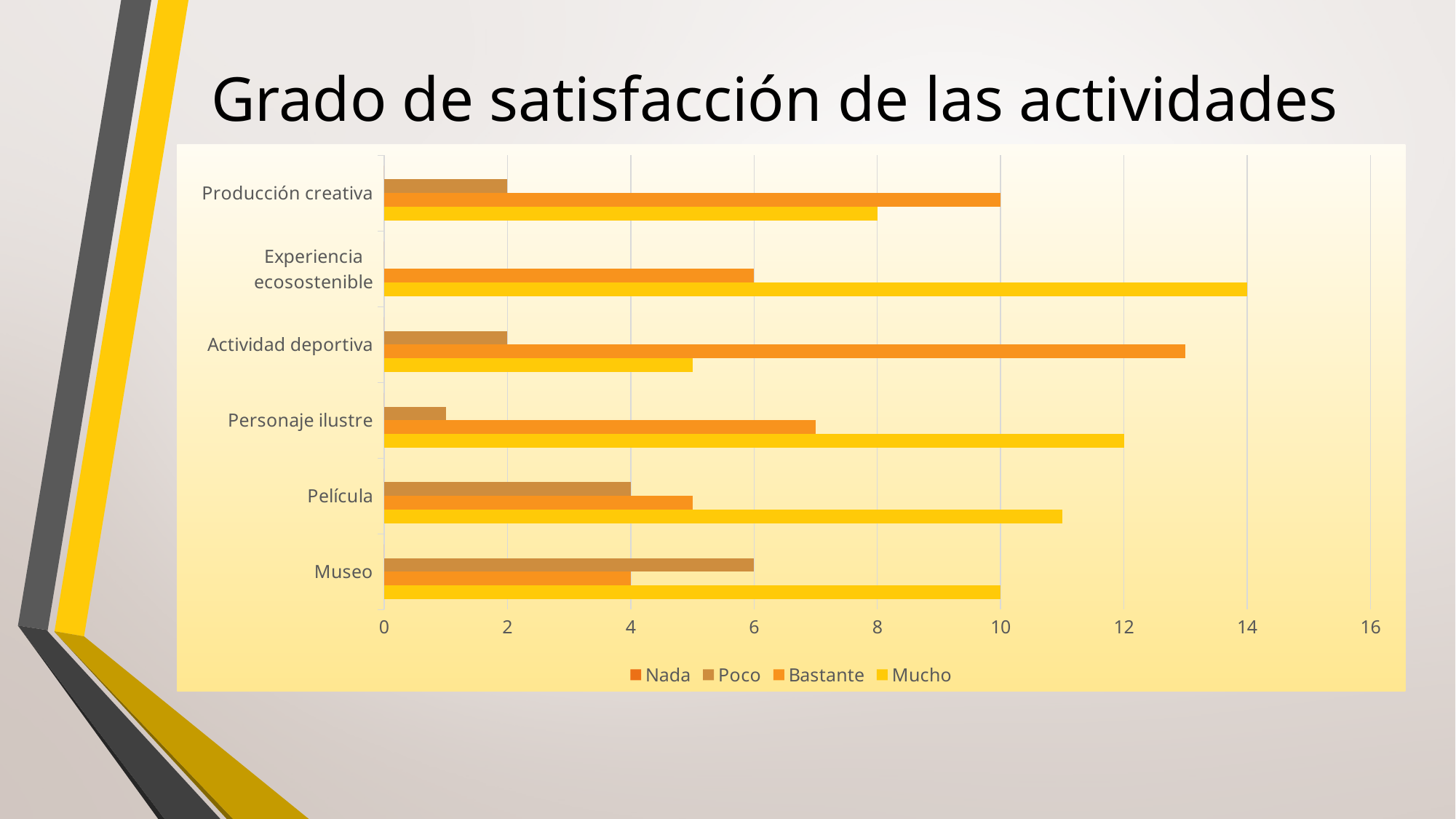
What is the 'Mucho' value for Personaje ilustre? 12 How many activities (categories) are shown on the chart? 6 For Museo, what is the difference between the 'Poco' value and the 'Bastante' value? 2 What is the 'Bastante' value for Producción creativa? 10 What is the 'Poco' value for Museo? 6 What kind of chart is shown on the slide? bar chart Which activity has the highest 'Mucho' value? Experiencia ecosostenible How many series does the legend list? 4 For Producción creativa, which is larger: the 'Bastante' value or the 'Mucho' value? Bastante Is the 'Bastante' value for Actividad deportiva greater or less than 12? greater What is the title of the chart on the slide? Grado de satisfacción de las actividades What is the 'Mucho' value for Experiencia ecosostenible? 14